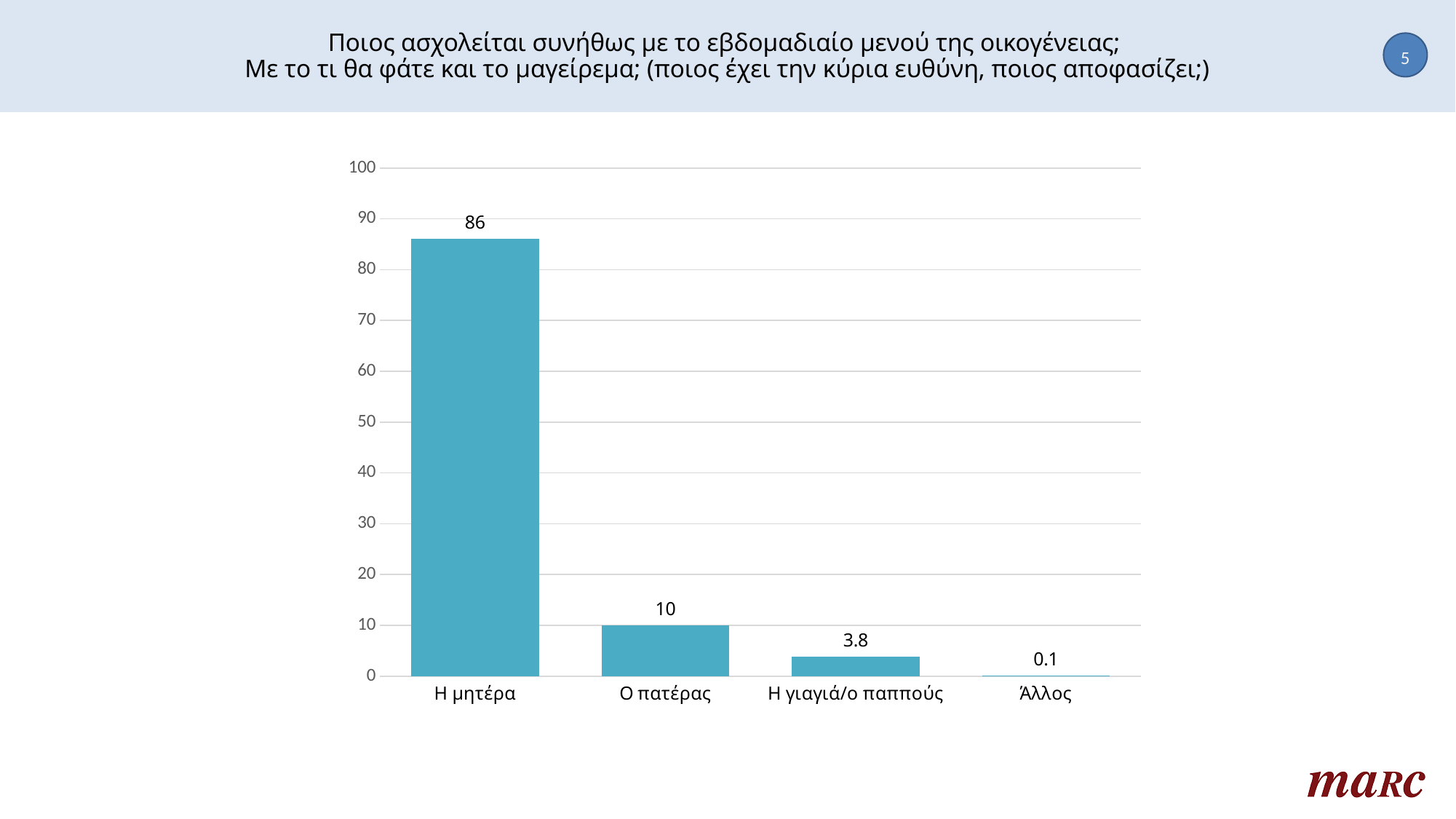
What is the difference between the values for Η μητέρα and Ο πατέρας? 76 Which category has the highest value? Η μητέρα What is the value for Η γιαγιά/ο παππούς? 3.8 What is the value for Ο πατέρας? 10 What is the value for Η μητέρα? 86 How many categories are shown on the x axis? 4 Which category has the lowest value? Άλλος What is the difference between the values for Ο πατέρας and Η γιαγιά/ο παππούς? 6.2 What is the value for Άλλος? 0.1 Is the value for Η μητέρα greater or less than 80? greater What kind of chart is shown on the slide? bar chart Which is larger, the value for Ο πατέρας or the value for Η γιαγιά/ο παππούς? Ο πατέρας